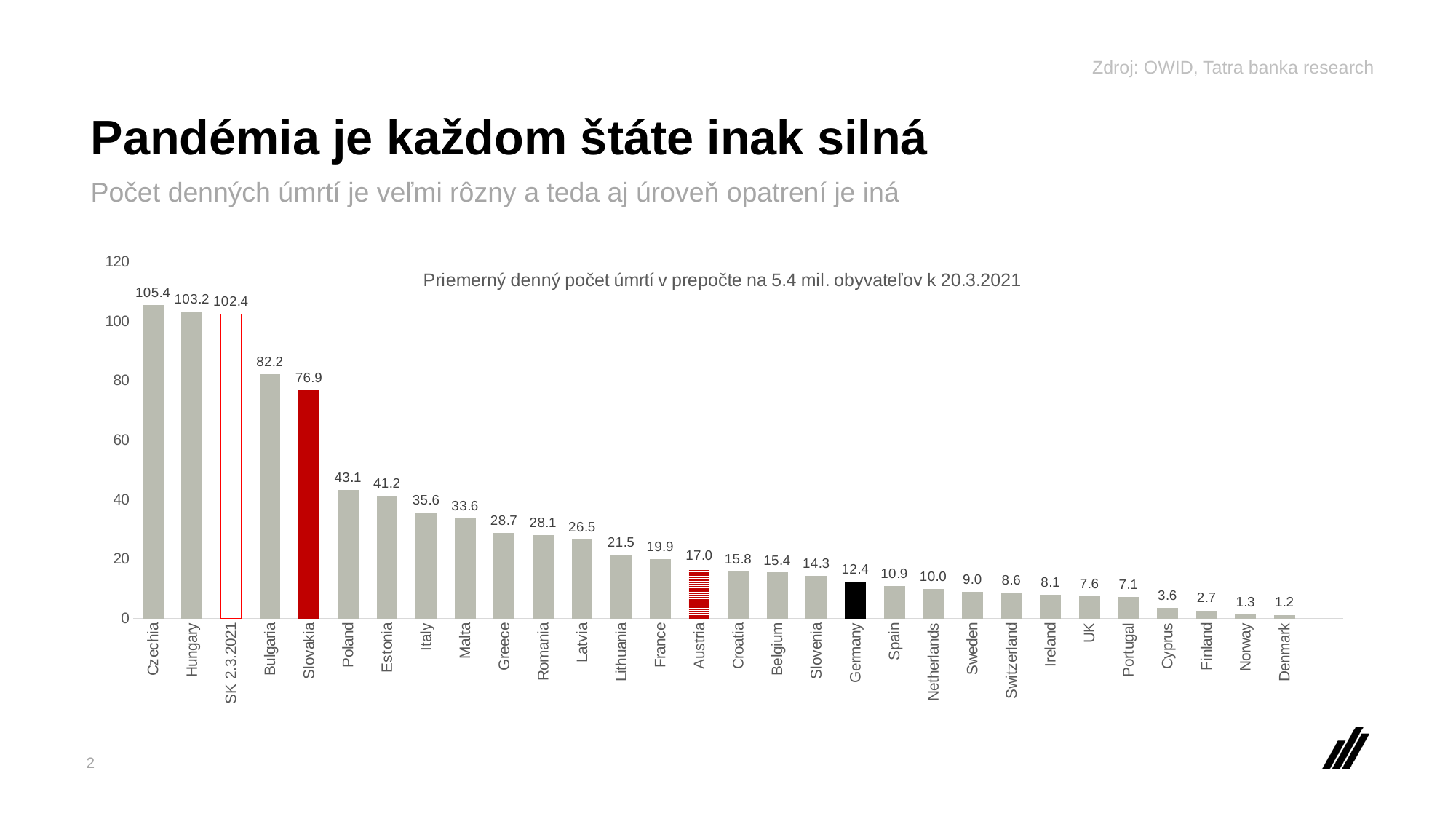
Is the value for Bulgaria greater or less than 80? greater Which is larger, the value for Poland or the value for Estonia? Poland What is the value for Germany? 12.4 How many countries/categories are shown on the chart? 30 What is the title of the chart? Priemerný denný počet úmrtí v prepočte na 5.4 mil. obyvateľov k 20.3.2021 Which country has the highest value? Czechia What is the value for SK 2.3.2021? 102.4 Which country has the lowest value? Denmark What is the value for Slovakia? 76.9 What kind of chart is shown on the slide? bar chart What is the difference between the values for Slovakia and Austria? 59.9 What is the difference between the values for Czechia and Hungary? 2.2